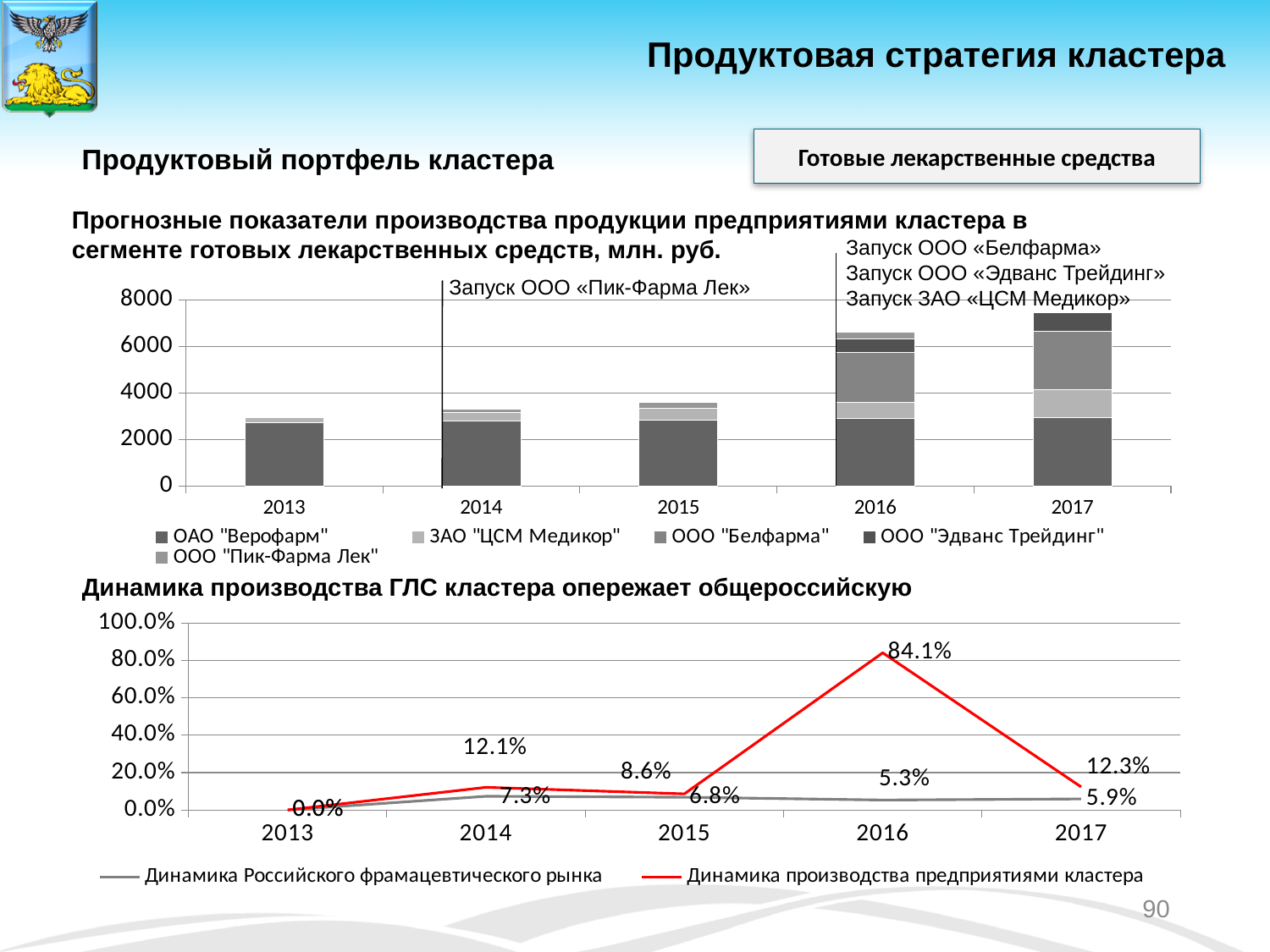
In the bottom line chart, what is the difference between the two series in 2016? 78.8% In the bottom line chart, which series has the larger value in 2015? Динамика производства предприятиями кластера In the bottom line chart, what is the value for 'Динамика производства предприятиями кластера' in 2016? 84.1% In the bottom line chart, what is the value for 'Динамика Российского фрамацевтического рынка' in 2014? 7.3% What kind of chart is the bottom chart on the slide? Line chart In the top bar chart, which year has the lowest total bar? 2013 In the bottom line chart, what is the value for 'Динамика производства предприятиями кластера' in 2017? 12.3% In the bottom line chart, how many series does the legend list? 2 In the top bar chart, how many series does the legend list? 5 What kind of chart is the top chart on the slide? Bar chart In the top bar chart, is the total value for 2017 greater or less than 6000? greater In the bottom line chart, in which year does 'Динамика производства предприятиями кластера' reach its highest value? 2016